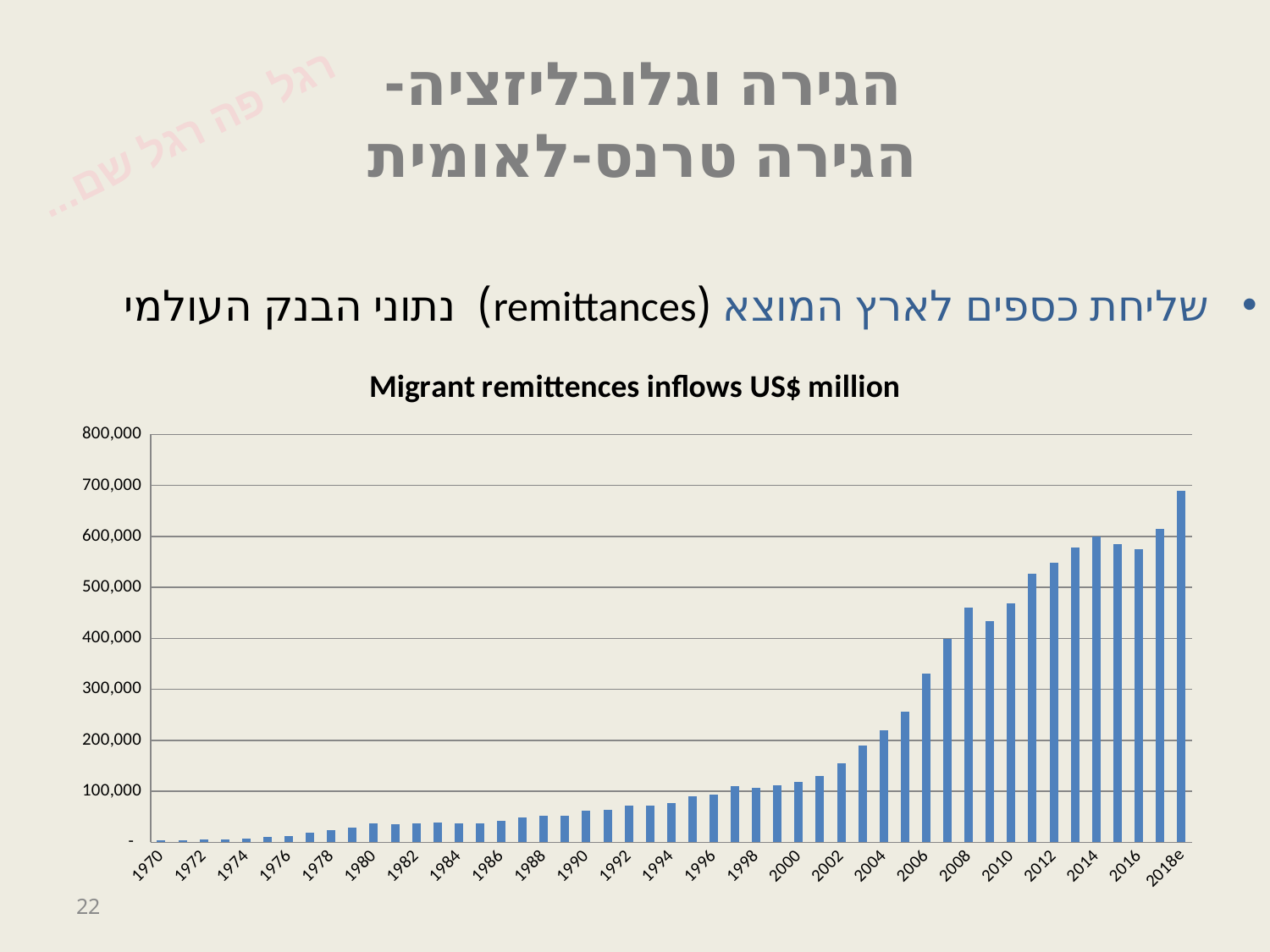
What kind of chart is shown on the slide? Bar chart What is the highest value shown on the vertical axis? 800,000 Is the value for 2018e greater or less than 600,000? greater What is the title of the chart? Migrant remittences inflows US$ million Which year has the lowest value in the chart? 1970 Which year has the larger value, 2012 or 2010? 2012 Do the values generally rise or fall from 1970 to 2018e? Rise Is the value for 2008 greater or less than 400,000? greater Which year has the highest value in the chart? 2018e Is the value for 2002 greater or less than 200,000? less Which year has the larger value, 2008 or 2009? 2008